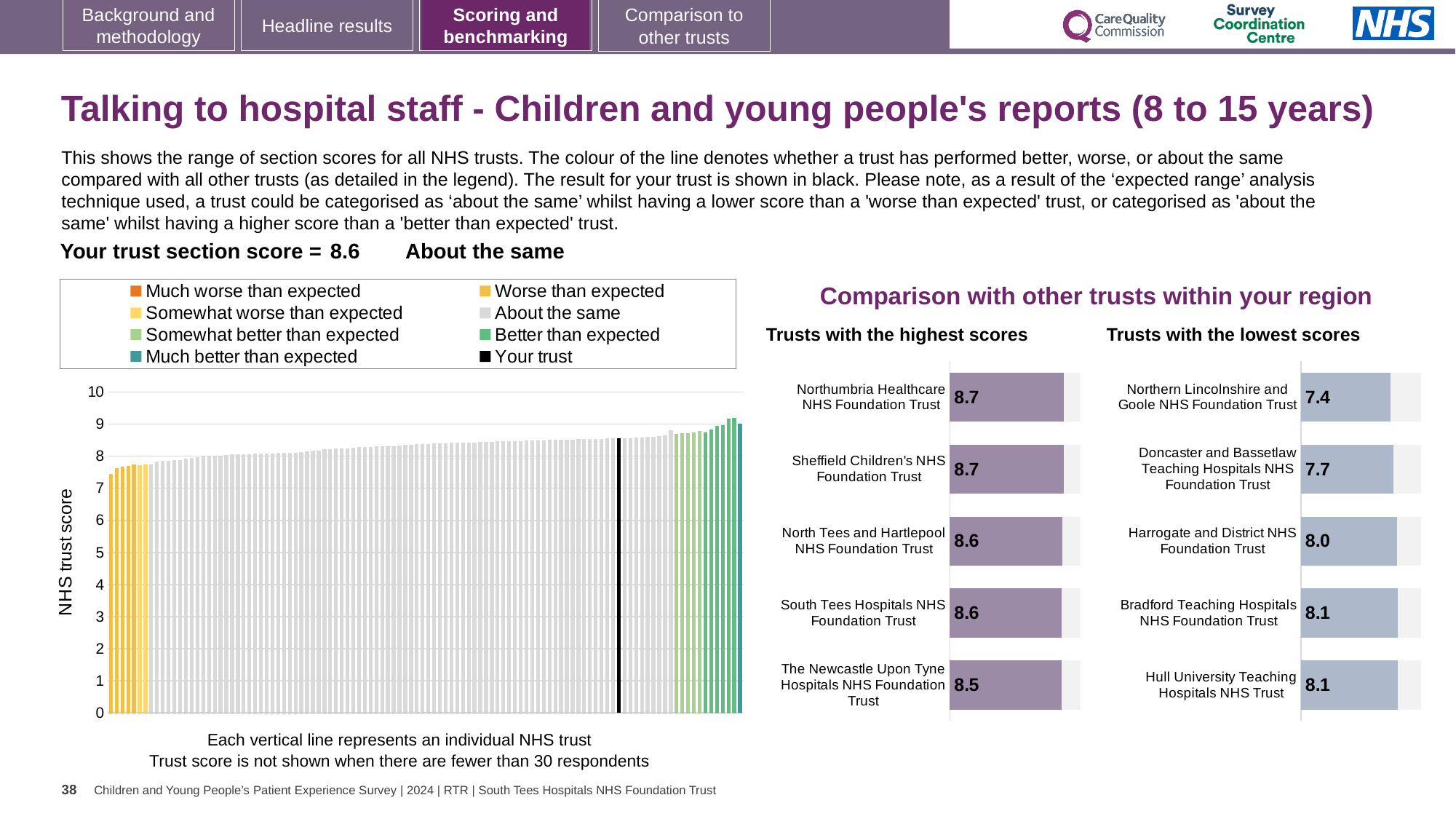
In the 'Trusts with the lowest scores' chart, which has the higher score: Doncaster and Bassetlaw Teaching Hospitals NHS Foundation Trust or Harrogate and District NHS Foundation Trust? Harrogate and District NHS Foundation Trust In the 'Trusts with the highest scores' chart, what is the difference between the scores of Northumbria Healthcare NHS Foundation Trust and The Newcastle Upon Tyne Hospitals NHS Foundation Trust? 0.2 In the 'Trusts with the lowest scores' chart, what is the difference between the scores of Harrogate and District NHS Foundation Trust and Northern Lincolnshire and Goole NHS Foundation Trust? 0.6 In the 'Trusts with the highest scores' chart, what is the score for Northumbria Healthcare NHS Foundation Trust? 8.7 What kind of chart is the main chart on the left of the slide? Bar chart In the 'Trusts with the lowest scores' chart, what is the score for Doncaster and Bassetlaw Teaching Hospitals NHS Foundation Trust? 7.7 How many trusts are listed in the 'Trusts with the highest scores' chart? 5 In the 'Trusts with the highest scores' chart, what is the score for The Newcastle Upon Tyne Hospitals NHS Foundation Trust? 8.5 In the main chart on the left, is the value for your trust (the black bar) greater or less than 8? greater In the 'Trusts with the lowest scores' chart, which trust has the lowest score? Northern Lincolnshire and Goole NHS Foundation Trust In the main chart on the left, what is the section score for your trust (the black bar)? 8.6 How many entries does the legend of the main chart on the left list? 8